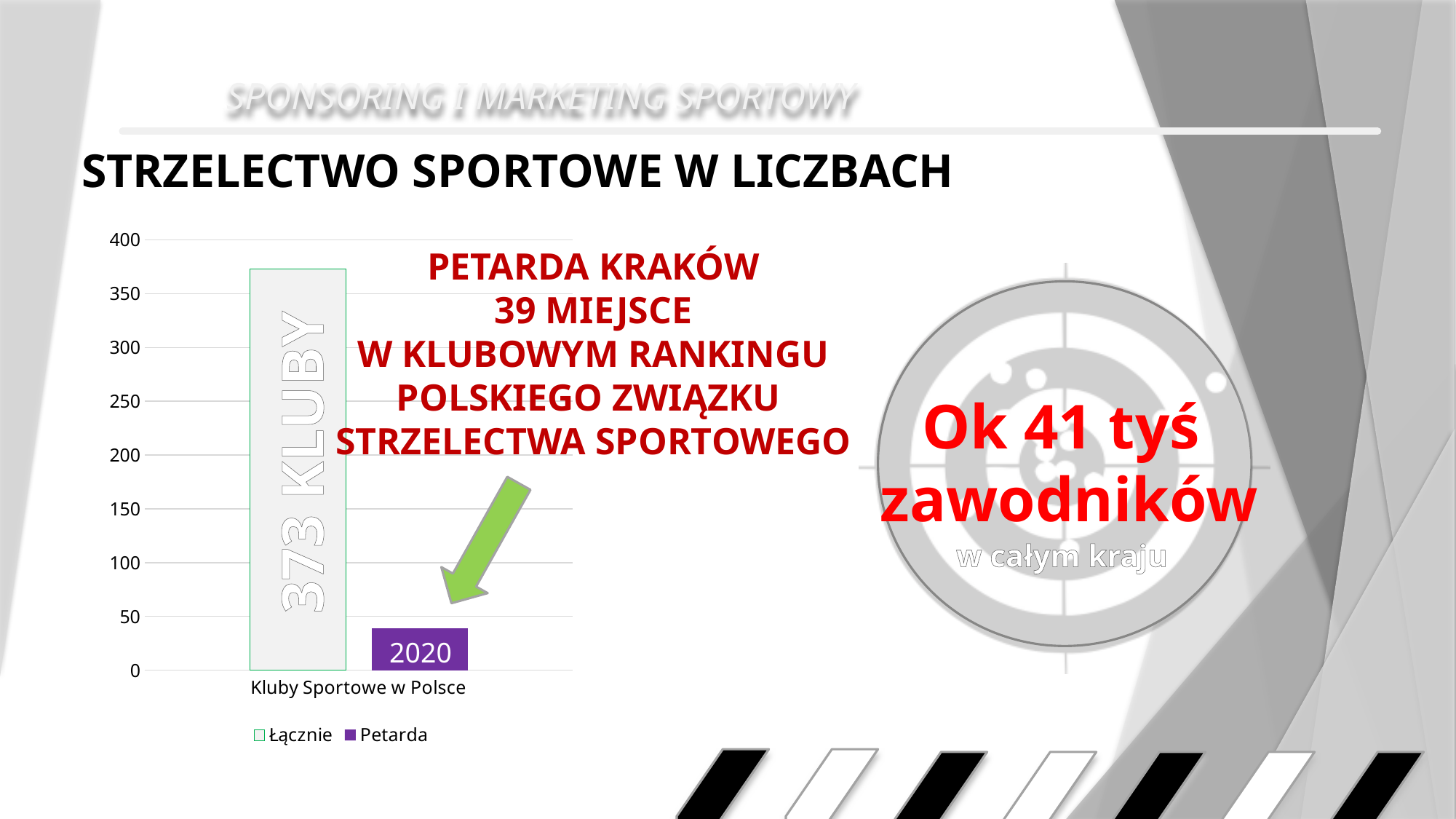
Which series has the highest bar in the chart? Łącznie Which series has the taller bar in the chart, Łącznie or Petarda? Łącznie Is the value for Petarda greater or less than 50? less What are the two series named in the chart legend? Łącznie and Petarda What kind of chart is shown on the slide? bar chart Is the value for Petarda greater or less than 100? less How many categories are shown on the x axis of the chart? 1 What value is printed on the Łącznie bar in the chart? 373 What is the category label on the x axis of the chart? Kluby Sportowe w Polsce Is the value for Łącznie greater or less than 350? greater How many series does the chart legend list? 2 Which series has the lowest bar in the chart? Petarda